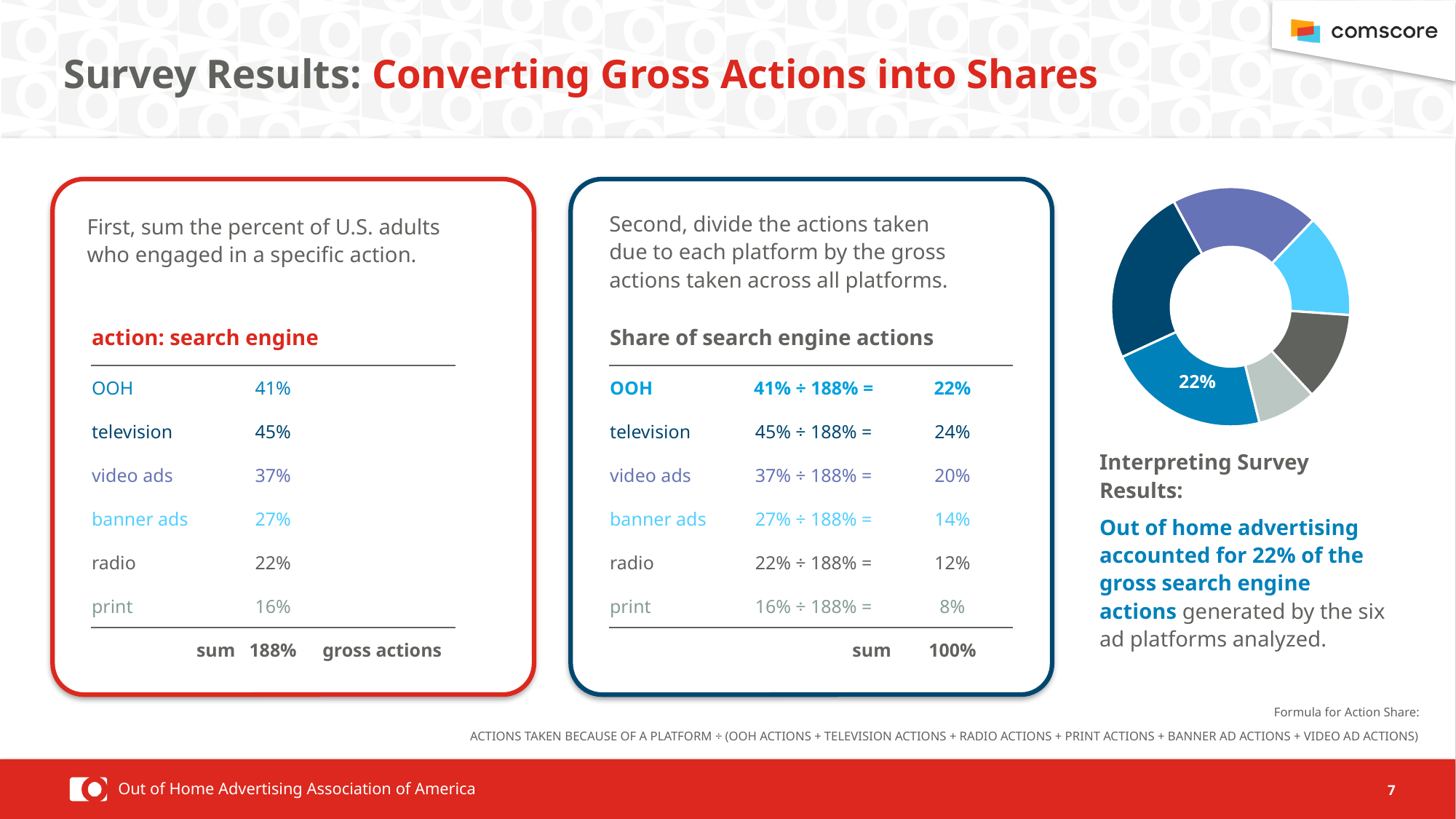
Does the donut chart include a legend? No According to the slide, which ad platform does the 22% slice of the donut chart represent? OOH (out of home advertising) What share of gross search engine actions does the labeled slice of the donut chart account for? 22% How many slices does the donut chart on the right contain? 6 What colour is the slice of the donut chart that carries the 22% label? Blue What kind of chart is shown on the right side of the slide? Donut (pie) chart What value is printed as a data label on the donut chart? 22% Is the share shown on the labeled slice of the donut chart greater or less than 25%? less